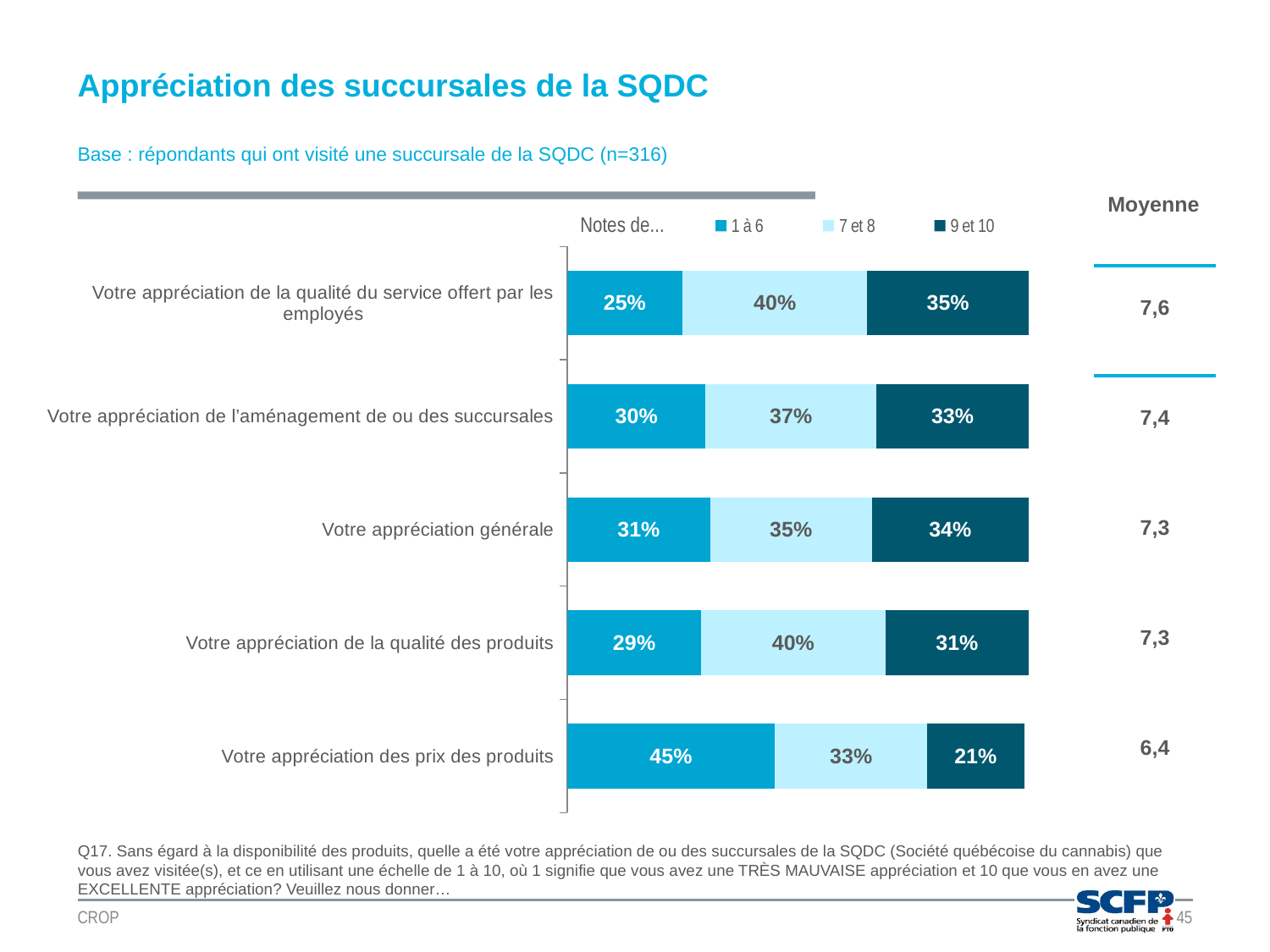
What percentage of respondents gave a score of 1 à 6 for "Votre appréciation des prix des produits"? 45% What is the difference between the 9 et 10 share for "Votre appréciation de la qualité du service offert par les employés" and for "Votre appréciation des prix des produits"? 14 percentage points What type of chart is shown on the slide? Stacked bar chart How many series does the legend list? 3 Which category has the highest Moyenne (average)? Votre appréciation de la qualité du service offert par les employés What is the base (n) of respondents stated on the slide? n=316 Which category has the lowest Moyenne (average)? Votre appréciation des prix des produits What percentage of respondents gave a score of 9 et 10 for "Votre appréciation de la qualité du service offert par les employés"? 35% What is the Moyenne (average) shown for "Votre appréciation de l'aménagement de ou des succursales"? 7,4 Which is larger: the 7 et 8 share for "Votre appréciation de la qualité des produits" or for "Votre appréciation générale"? Votre appréciation de la qualité des produits Which category has the highest share of 1 à 6 scores? Votre appréciation des prix des produits How many categories (statements) are shown in the chart? 5